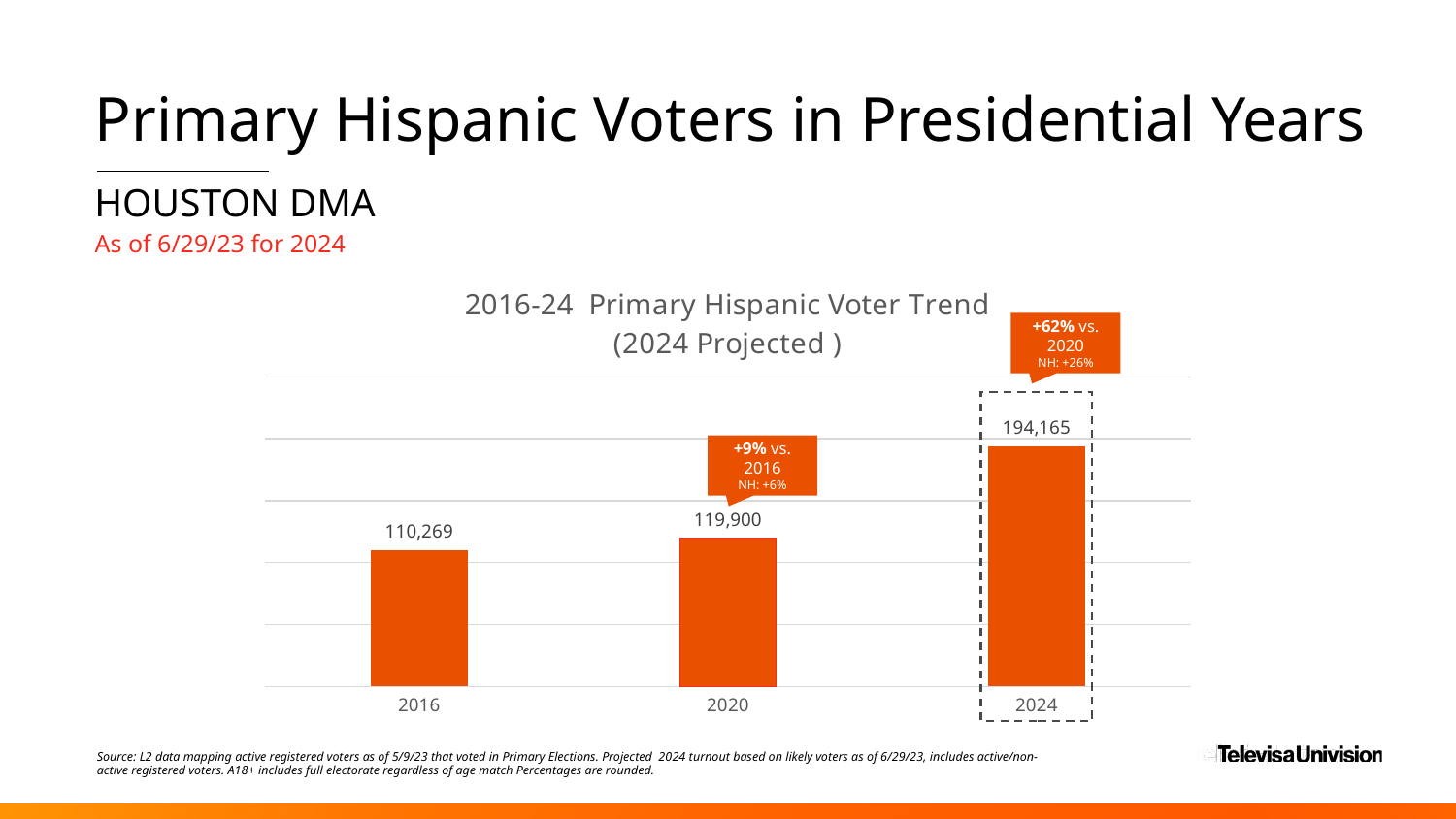
What kind of chart is this? Bar chart Which year has the highest value? 2024 What is the difference between the 2020 and 2016 values? 9,631 What is the projected value for 2024? 194,165 What is the value for 2020? 119,900 What is the value for 2016? 110,269 What percentage change vs. 2020 is shown in the callout above the 2024 bar? +62% What is the difference between the 2024 and 2020 values? 74,265 Do the values rise or fall from 2016 to 2024? Rise Which year has the lowest value? 2016 Which is larger, the value for 2020 or the value for 2016? 2020 How many years are shown on the chart? 3